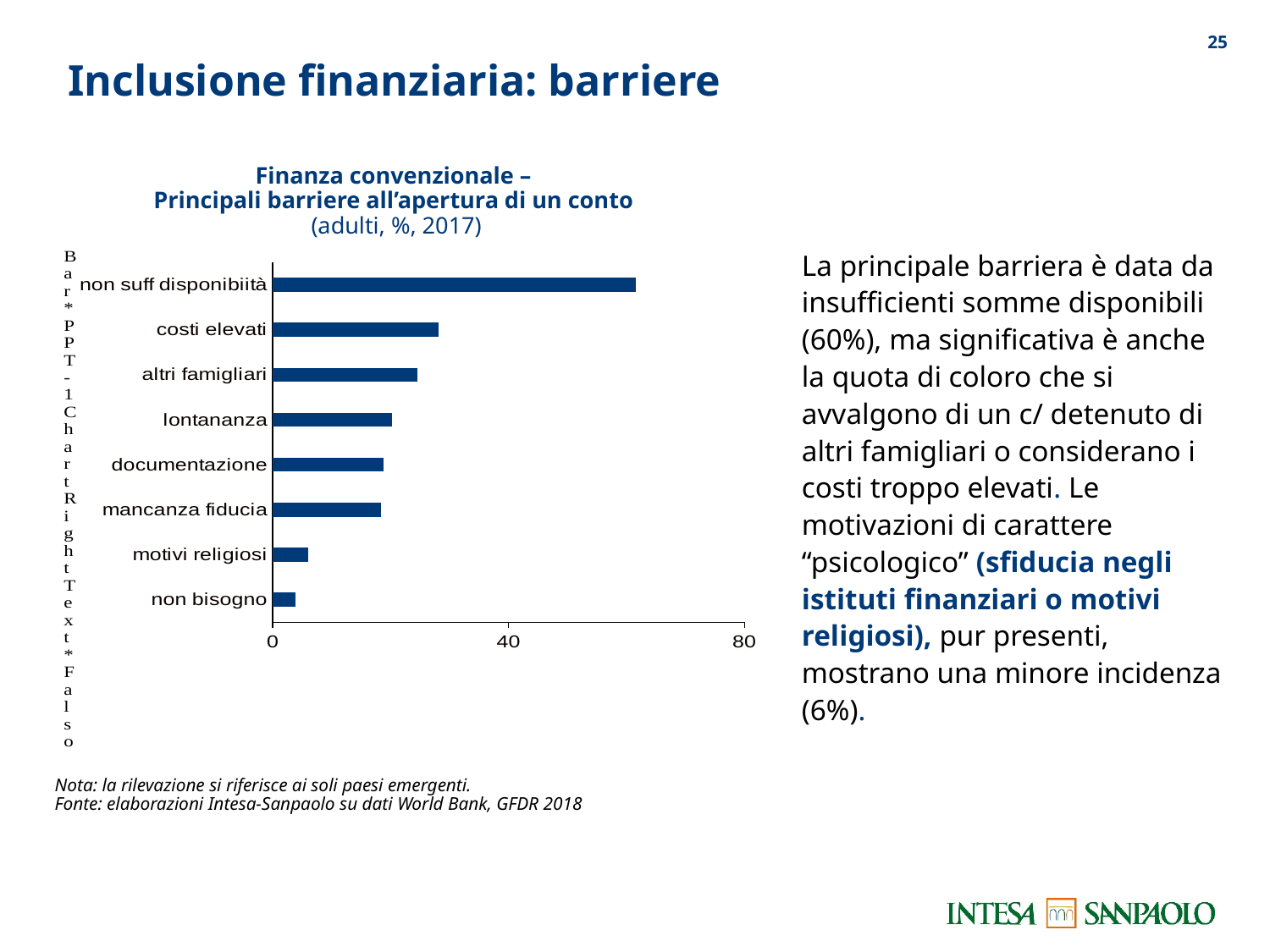
How many categories (barriers) are plotted in the chart? 8 Is the value for 'motivi religiosi' greater or less than 40? less Which is larger, the value for 'altri famigliari' or the value for 'motivi religiosi'? altri famigliari Which is larger, the value for 'costi elevati' or the value for 'lontananza'? costi elevati Is the value for 'costi elevati' greater or less than 40? less Which is larger, the value for 'non suff disponibiità' or the value for 'costi elevati'? non suff disponibiità Is the value for 'non suff disponibiità' greater or less than 40? greater What year do the chart's data refer to, according to the subtitle? 2017 Which barrier has the lowest value in the chart? non bisogno Which barrier has the highest value in the chart? non suff disponibiità What is the title of the chart? Finanza convenzionale – Principali barriere all'apertura di un conto What kind of chart is shown on the slide? bar chart